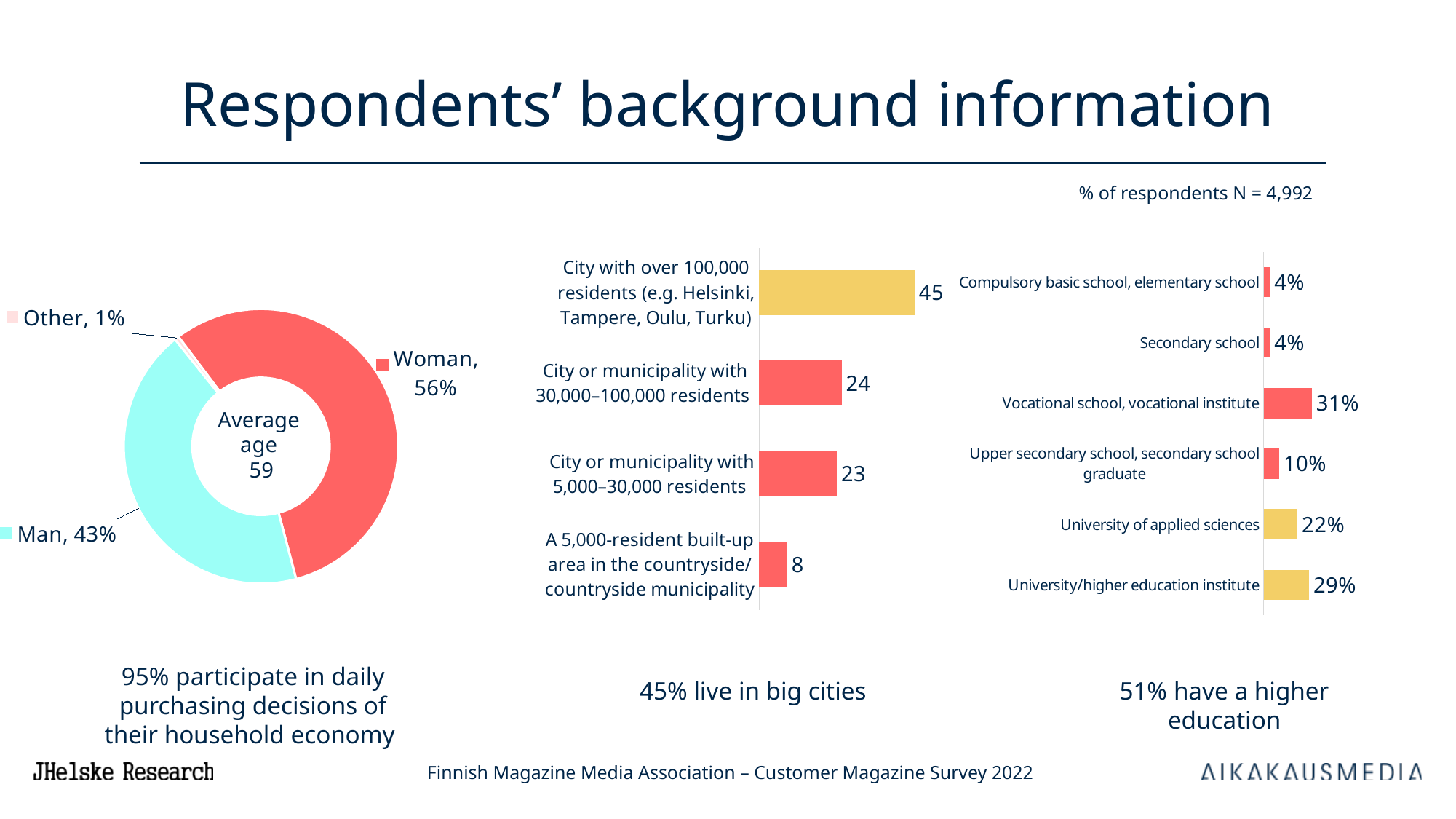
In the education bar chart on the right, which category has the highest value? Vocational school, vocational institute In the place-of-residence bar chart in the middle, which category has the lowest value? A 5,000-resident built-up area in the countryside/countryside municipality In the place-of-residence bar chart in the middle, which category has the highest value? City with over 100,000 residents (e.g. Helsinki, Tampere, Oulu, Turku) In the place-of-residence bar chart in the middle, what is the value for 'City or municipality with 30,000–100,000 residents'? 24 In the education bar chart on the right, what is the value for 'Vocational school, vocational institute'? 31% In the gender donut chart on the left, what share of respondents are women? 56% In the education bar chart on the right, which is larger: 'University of applied sciences' or 'University/higher education institute'? University/higher education institute In the gender donut chart on the left, what share of respondents are men? 43% In the education bar chart on the right, how many categories are shown? 6 In the gender donut chart on the left, how many categories are shown? 3 What kind of chart is the gender chart on the left? Donut (pie) chart In the place-of-residence bar chart in the middle, what is the difference between the value for cities with over 100,000 residents and the value for the countryside category? 37